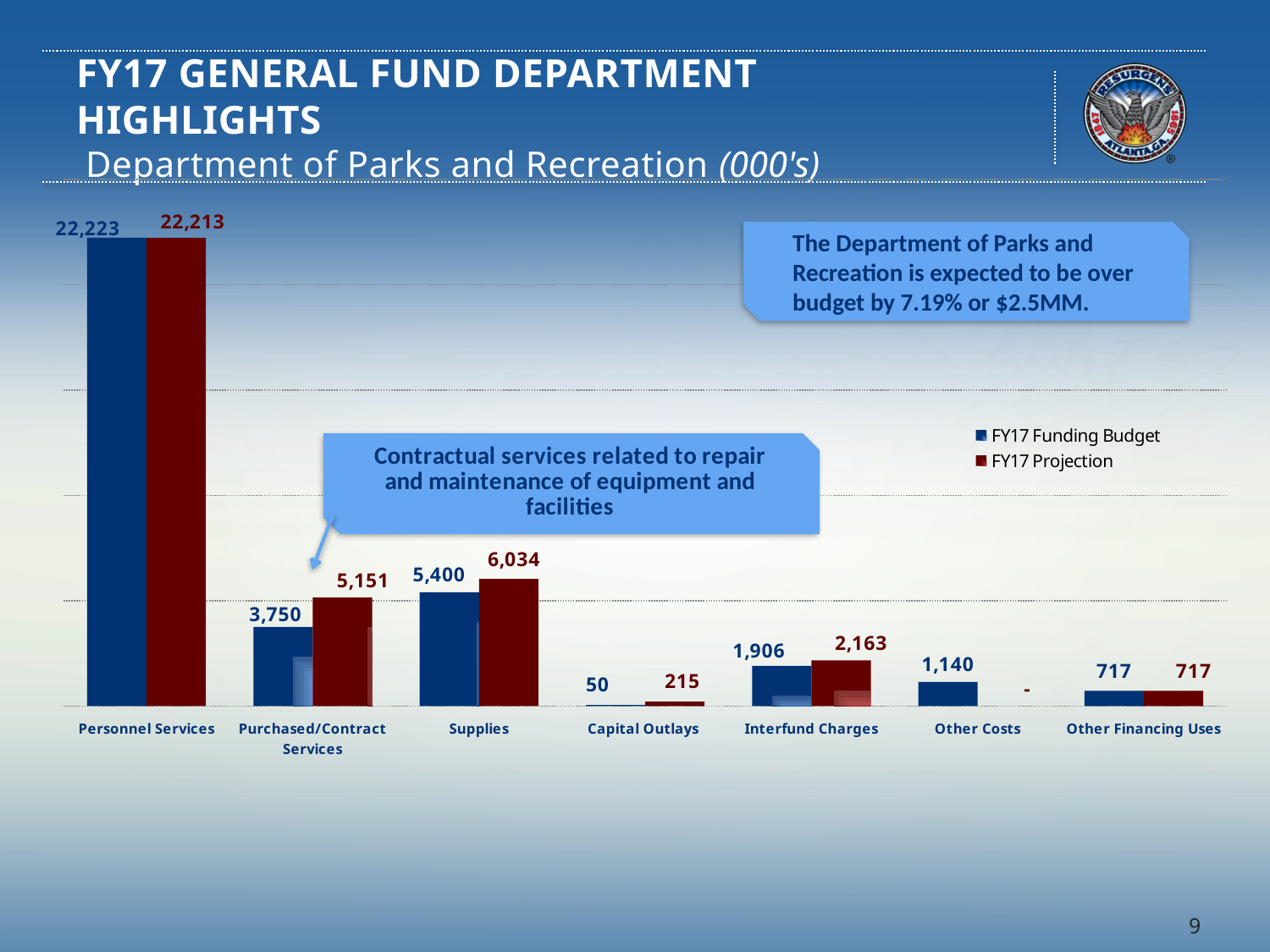
How many series does the chart legend list? 2 What is the FY17 Funding Budget value for Capital Outlays? 50 How many categories are shown on the x axis of the chart? 7 Which is larger for Supplies, the FY17 Funding Budget or the FY17 Projection? FY17 Projection What is the difference between the FY17 Projection and the FY17 Funding Budget for Purchased/Contract Services? 1,401 What is the difference between the FY17 Projection and the FY17 Funding Budget for Interfund Charges? 257 What is the FY17 Funding Budget value for Personnel Services? 22,223 What is the FY17 Projection value for Purchased/Contract Services? 5,151 What type of chart is shown on the slide? Bar chart What is the FY17 Projection value for Supplies? 6,034 Which category has the highest FY17 Projection value? Personnel Services Which category has the lowest FY17 Funding Budget value? Capital Outlays